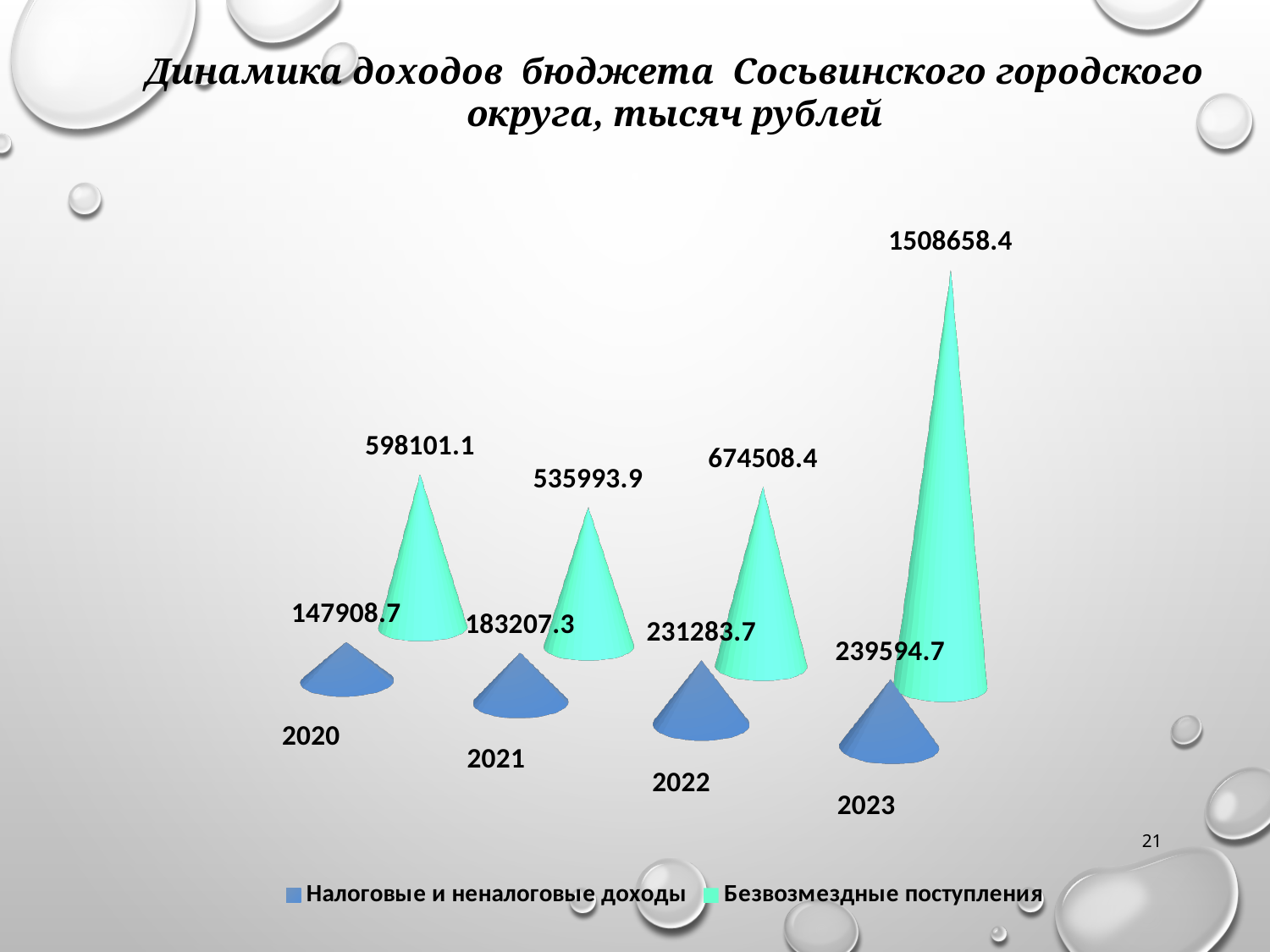
How many years are shown on the x axis? 4 How many series does the legend list? 2 What is the value for Налоговые и неналоговые доходы in 2020? 147908.7 What kind of chart is shown on the slide? Bar chart In which year is Налоговые и неналоговые доходы lowest? 2020 What is the difference between Безвозмездные поступления in 2023 and in 2022? 834150.0 In which year is Безвозмездные поступления highest? 2023 What is the value for Безвозмездные поступления in 2023? 1508658.4 What is the value for Безвозмездные поступления in 2021? 535993.9 Which is larger: Безвозмездные поступления in 2020 or in 2021? 2020 Do the values for Налоговые и неналоговые доходы rise or fall from 2020 to 2023? Rise What is the value for Налоговые и неналоговые доходы in 2022? 231283.7